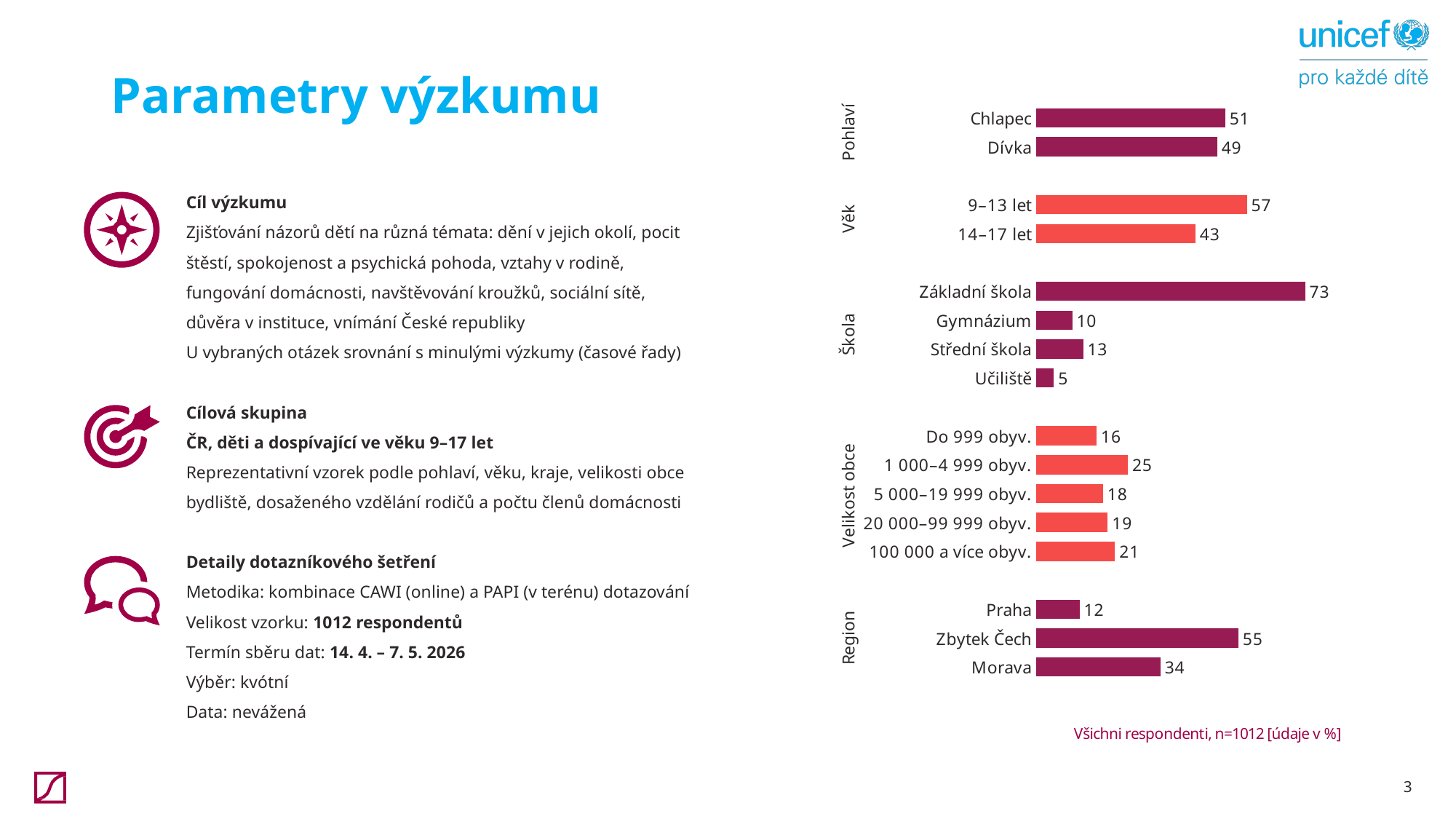
What kind of chart is shown on the slide? Bar chart What is the total of the values for Praha, Zbytek Čech and Morava? 101 Which category in the Velikost obce group has the lowest value? Do 999 obyv. What is the value for 1 000–4 999 obyv. in the chart? 25 Which category in the Region group has the highest value? Zbytek Čech What is the value for Chlapec in the chart? 51 According to the note below the chart, what is the sample size n? 1012 What is the value for Základní škola in the chart? 73 Which category in the Škola group has the lowest value? Učiliště Which is larger, the value for Praha or the value for Morava? Morava How many categories are shown in the Velikost obce group? 5 What is the difference between the values for 9–13 let and 14–17 let? 14